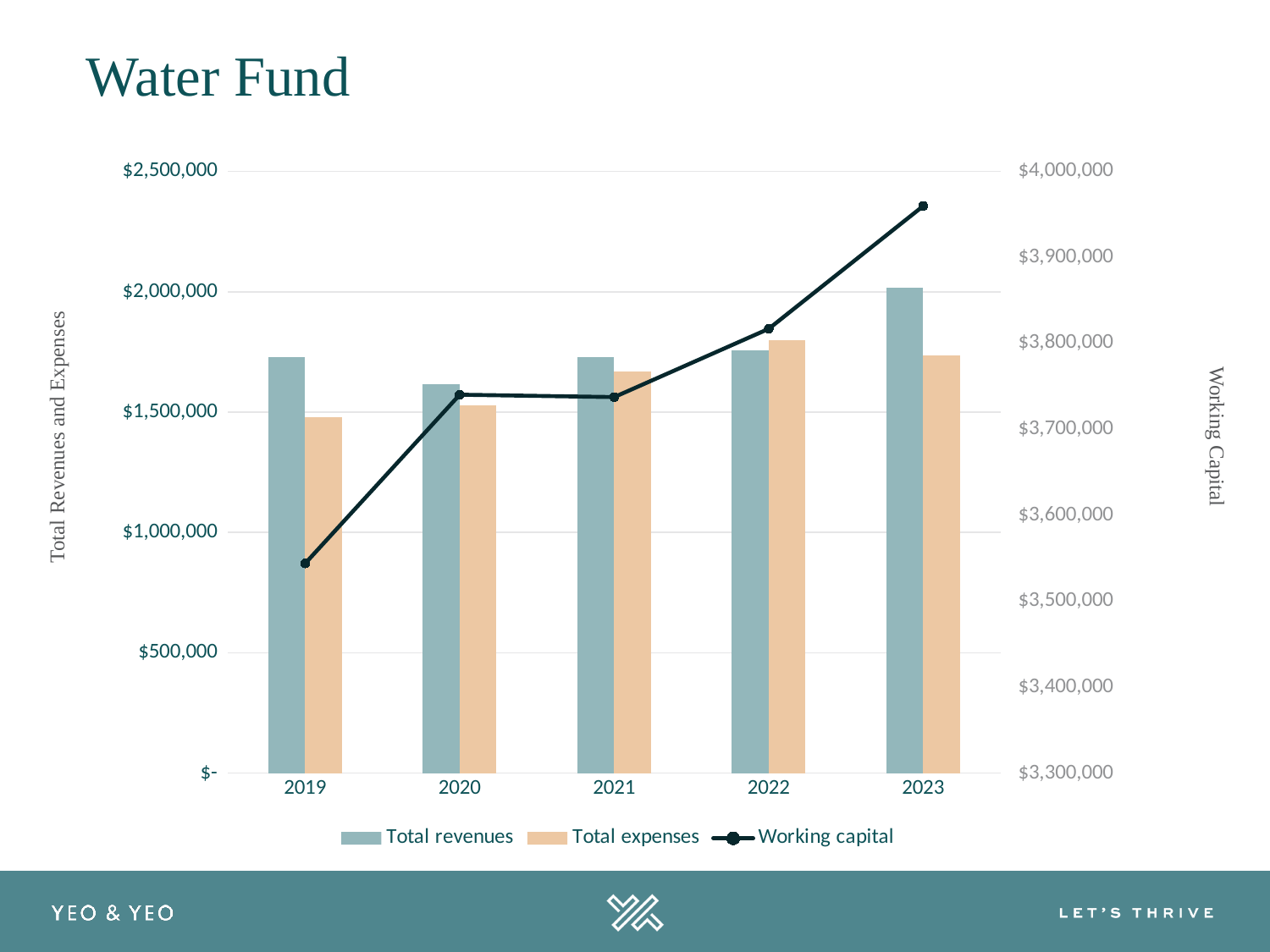
What kind of chart is shown on the slide? A bar chart combined with a line Does Working capital generally rise or fall from 2019 to 2023? Rise In which year are Total revenues highest? 2023 How many series does the legend list? 3 In which year are Total revenues lowest? 2020 In which year is Working capital lowest? 2019 How many years are shown on the x axis? 5 In which year are Total expenses lowest? 2019 In which year are Total expenses highest? 2022 Is the Working capital value for 2019 greater or less than $3,600,000? less In 2019, which is larger, Total revenues or Total expenses? Total revenues Is the Total revenues value for 2020 greater or less than $1,500,000? greater